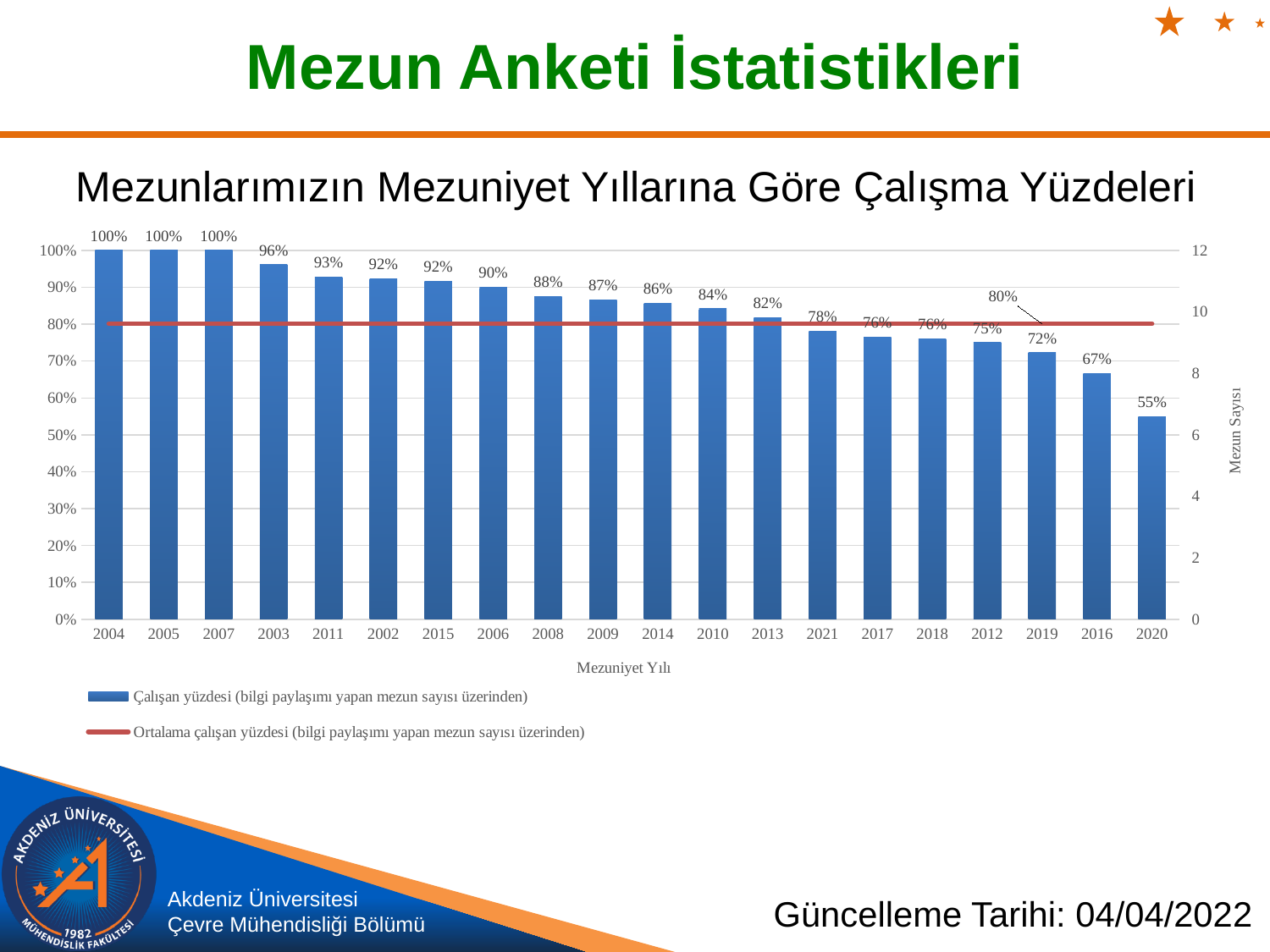
How many graduation years are shown on the x axis of the chart? 20 What is the difference in employment percentage between the 2003 and 2016 graduation years? 29% What is the employment percentage shown for the 2011 graduation year? 93% Do the employment percentages rise or fall moving from left to right along the x axis? Fall How many series does the chart legend list? 2 What kind of chart is used to show the employment percentages by graduation year? Bar chart Is the employment percentage for the 2012 graduation year greater or less than 80%? less What is the employment percentage (Çalışan yüzdesi) for the 2020 graduation year? 55% What is the employment percentage shown for the 2021 graduation year? 78% What value does the red average line (Ortalama çalışan yüzdesi) show? 80% Which has a higher employment percentage, the 2010 graduation year or the 2019 graduation year? 2010 Which graduation year has the lowest employment percentage? 2020